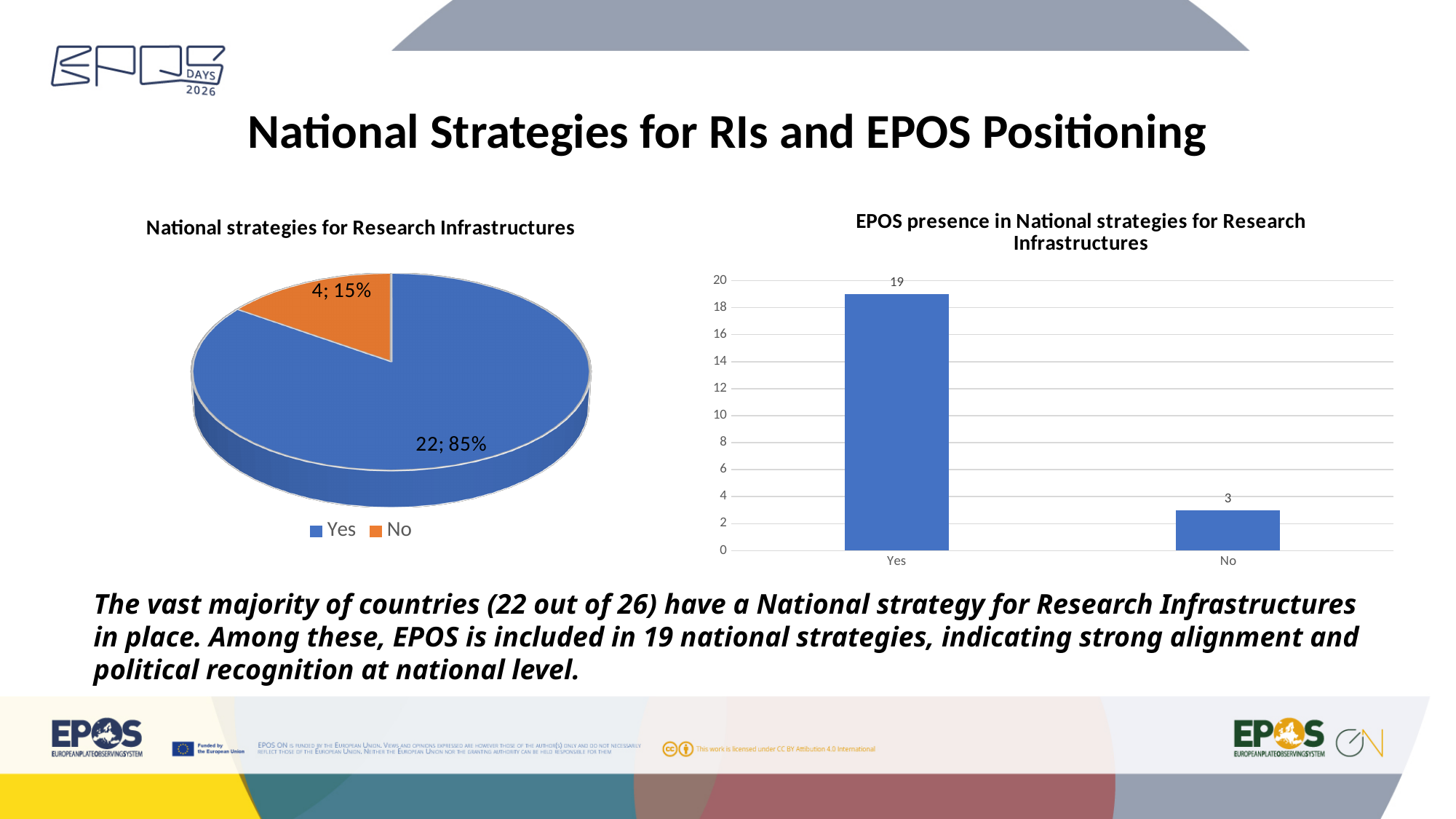
In the 'National strategies for Research Infrastructures' pie chart, which category has the largest slice? Yes What type of chart is 'National strategies for Research Infrastructures'? Pie chart In the 'National strategies for Research Infrastructures' pie chart, how many countries answered Yes? 22 In the 'National strategies for Research Infrastructures' pie chart, what percentage share does the No slice have? 15% In the 'National strategies for Research Infrastructures' pie chart, what percentage share does the Yes slice have? 85% How many entries does the legend of the 'National strategies for Research Infrastructures' chart list? 2 In the 'National strategies for Research Infrastructures' pie chart, what is the total count across both slices? 26 In the 'EPOS presence in National strategies for Research Infrastructures' chart, what is the difference between the Yes and No values? 16 What type of chart is 'EPOS presence in National strategies for Research Infrastructures'? Bar chart In the 'EPOS presence in National strategies for Research Infrastructures' chart, what is the value for Yes? 19 In the 'EPOS presence in National strategies for Research Infrastructures' chart, what is the value for No? 3 In the 'EPOS presence in National strategies for Research Infrastructures' chart, how many categories are shown on the x axis? 2